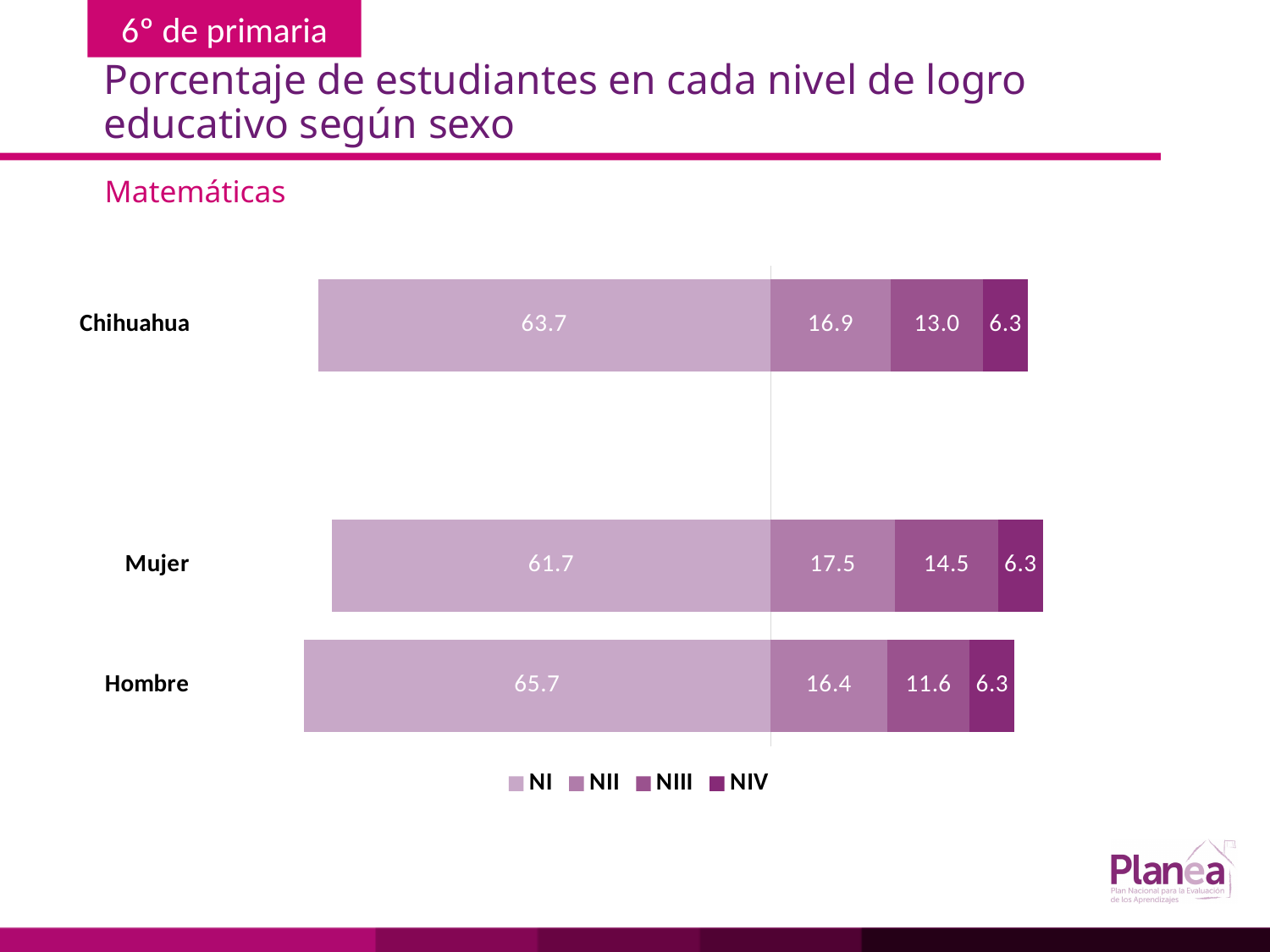
How many series does the legend list? 4 What is the total of the stacked bar for Chihuahua? 99.9 What kind of chart is shown on the slide? Stacked bar chart What is the NI value for Chihuahua? 63.7 What is the NIII value for Mujer? 14.5 What subject is the chart about, according to the subtitle above it? Matemáticas Which category has the lowest NIII value? Hombre Which category has the highest NI value? Hombre What is the NII value for Hombre? 16.4 How many categories are shown on the chart? 3 What is the difference between the NI values for Hombre and Mujer? 4.0 Which is larger, the NII value for Mujer or the NII value for Chihuahua? Mujer